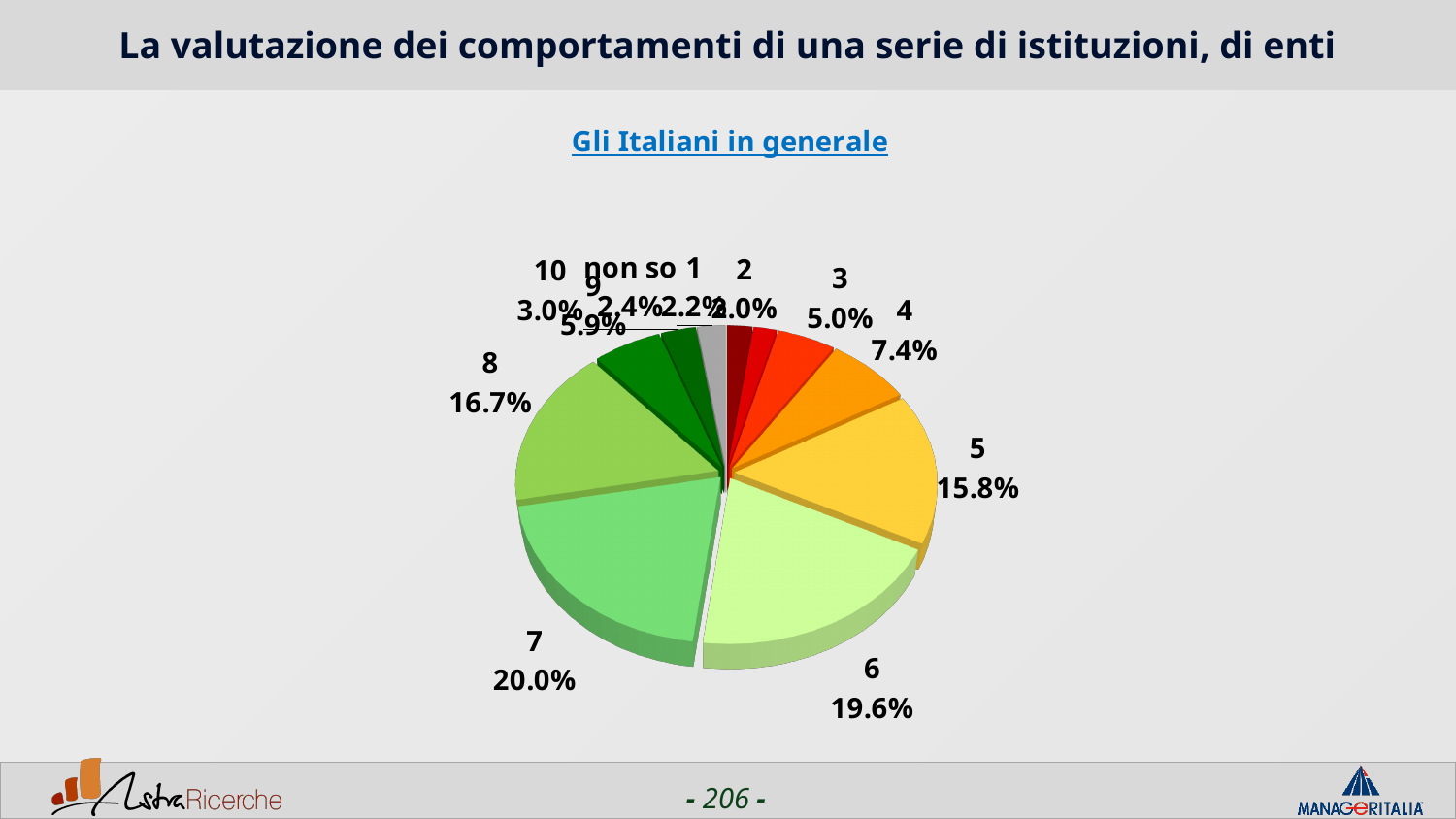
Which category has the largest slice of the pie? 7 What percentage is shown for category 4? 7.4% Which is larger, the slice for category 8 or the slice for category 5? 8 What type of chart is shown on the slide? Pie chart What is the value shown for category 6? 19.6% What is the value for the 'non so' slice? 2.4% What is the difference in percentage points between category 7 and category 6? 0.4 What percentage is shown for category 10? 3.0% What is the value for category 8? 16.7% What percentage is shown for category 5? 15.8% What share of the pie does category 7 represent? 20.0% How many slices does the pie chart have? 11